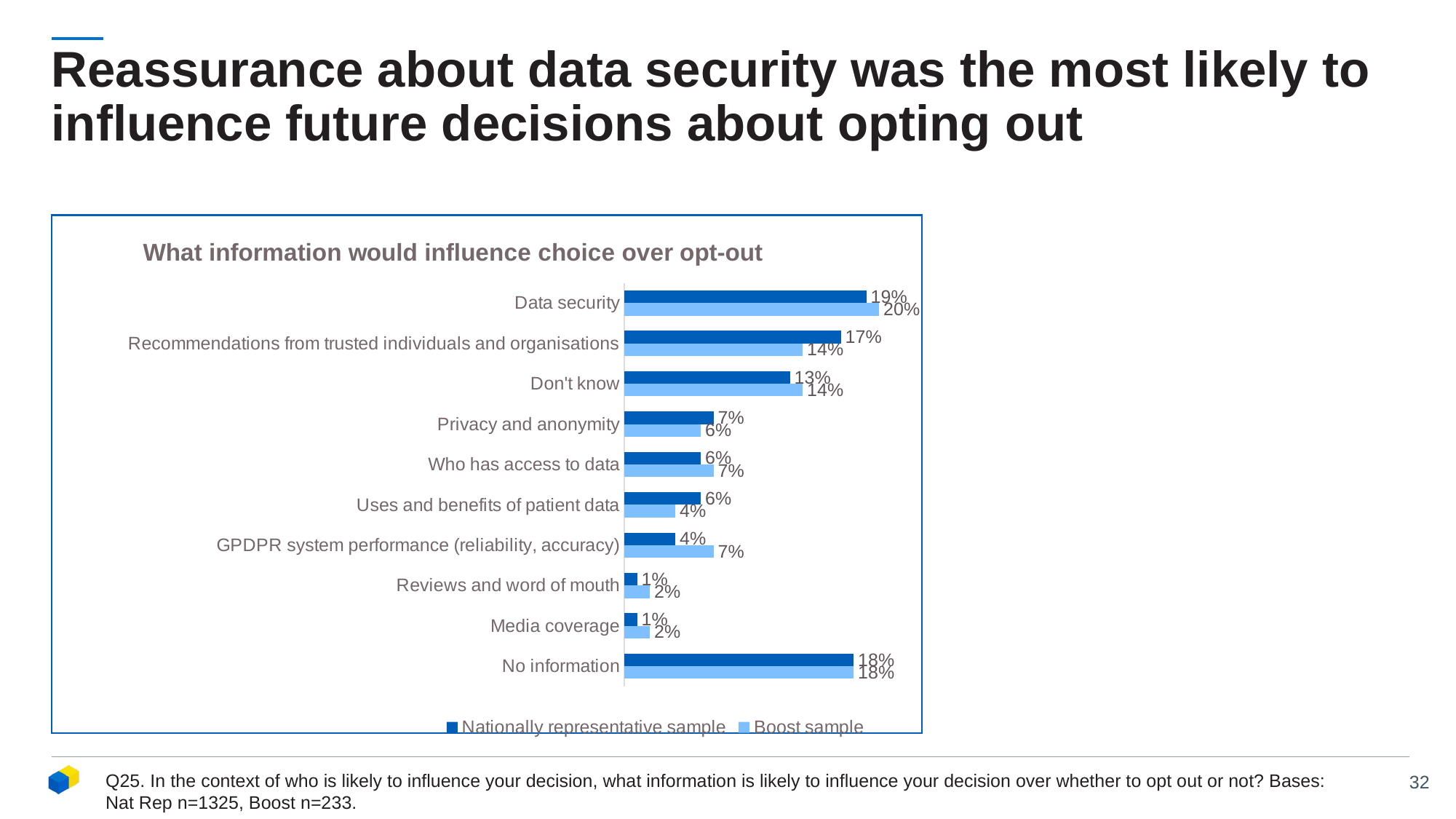
What is the value for No information in the Nationally representative sample? 18% What is the title of the chart? What information would influence choice over opt-out What is the value for GPDPR system performance (reliability, accuracy) in the Boost sample? 7% How many categories are shown on the chart? 10 What is the difference between the Nationally representative sample and Boost sample values for Recommendations from trusted individuals and organisations? 3% How many series does the legend list? 2 Which category has the highest value in the Boost sample? Data security What is the value for Data security in the Nationally representative sample? 19% Which category has the highest value in the Nationally representative sample? Data security Which is larger for Uses and benefits of patient data: the Nationally representative sample or the Boost sample? Nationally representative sample What kind of chart is shown on the slide? Bar chart What is the value for Don't know in the Boost sample? 14%